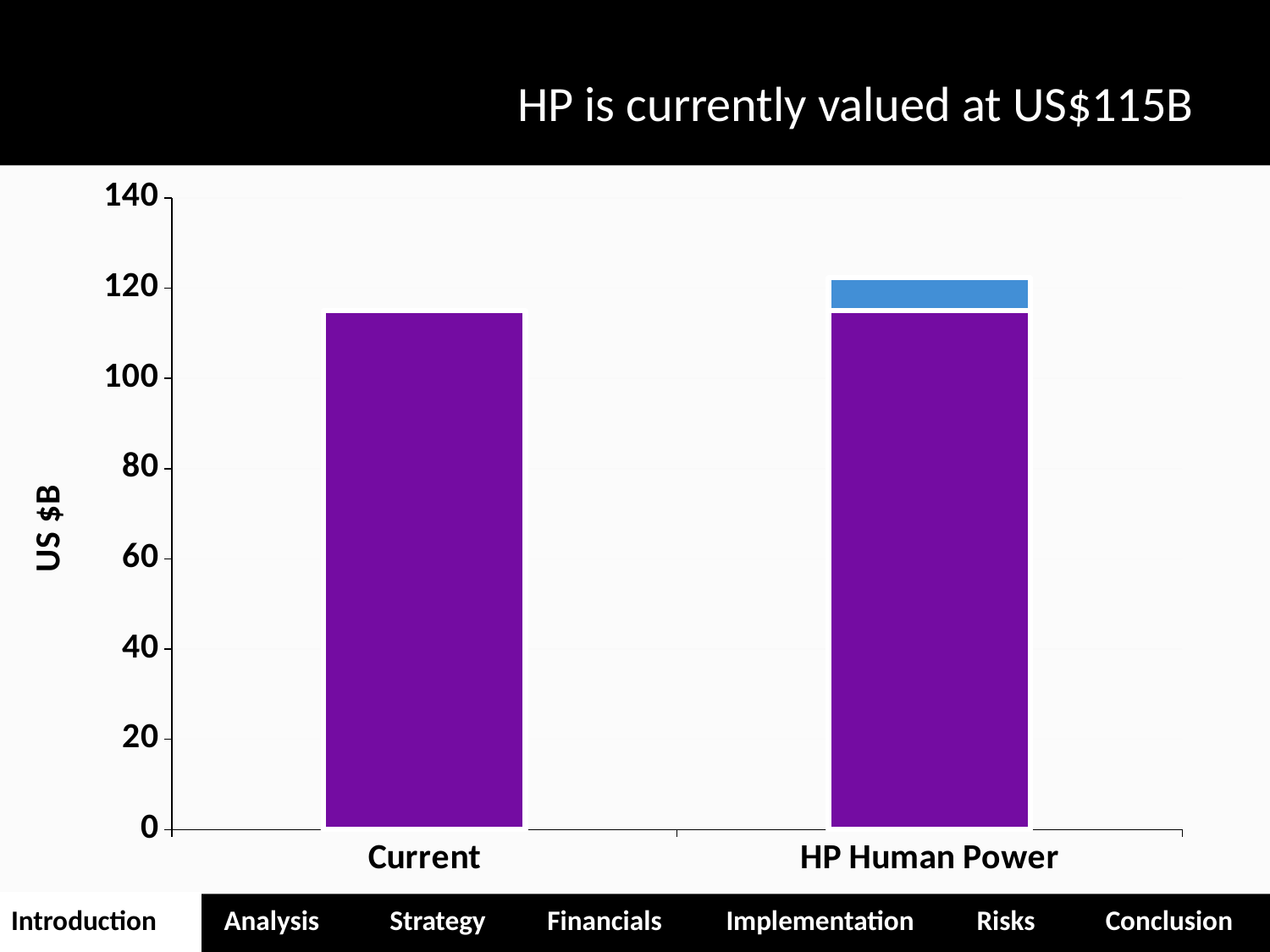
Is the value for Current greater or less than 100? greater Which category has the lowest total bar in the chart? Current Is the total value for HP Human Power greater or less than 100? greater What colour is the top segment of the HP Human Power bar? blue Which category has the highest total bar in the chart? HP Human Power Which category has the taller bar overall, Current or HP Human Power? HP Human Power How many categories are shown on the x axis of the chart? 2 What is the label on the vertical axis of the chart? US $B Is the total value for HP Human Power greater or less than 140? less What kind of chart is shown on the slide? bar chart